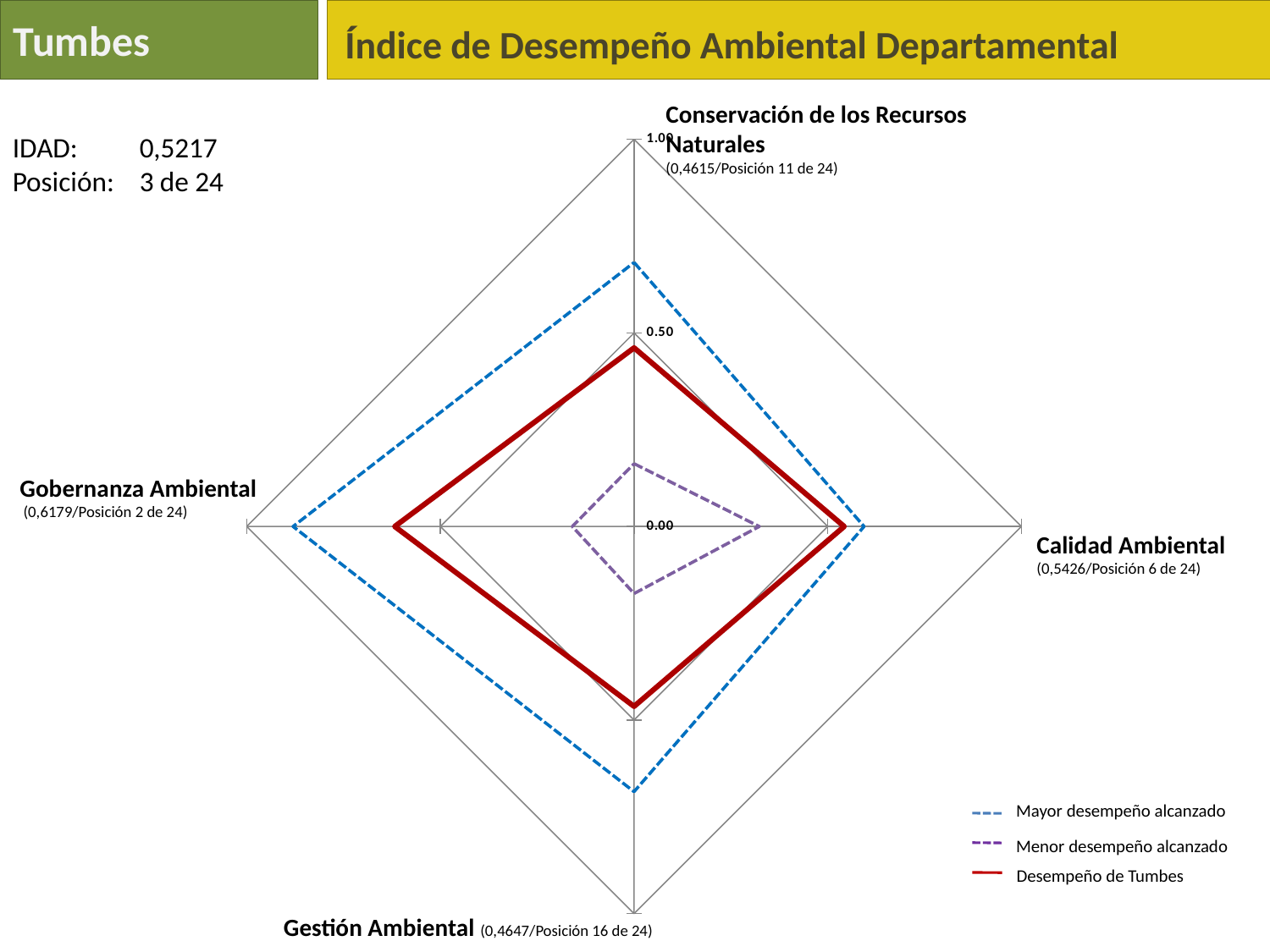
Which is larger for Tumbes: Calidad Ambiental or Gestión Ambiental? Calidad Ambiental What is the value for Calidad Ambiental in the Desempeño de Tumbes series? 0,5426 Which axis has the lowest value for Desempeño de Tumbes? Conservación de los Recursos Naturales How many series does the legend list? 3 Which axis has the highest value for Desempeño de Tumbes? Gobernanza Ambiental What is the value for Gestión Ambiental in the Desempeño de Tumbes series? 0,4647 What is the value for Conservación de los Recursos Naturales in the Desempeño de Tumbes series? 0,4615 What is the difference between the Tumbes values for Gobernanza Ambiental and Conservación de los Recursos Naturales? 0,1564 Is the value for Calidad Ambiental in the Menor desempeño alcanzado series greater or less than 0.50? less Is the value for Gobernanza Ambiental in the Mayor desempeño alcanzado series greater or less than 0.50? greater What kind of chart is shown on the slide? Radar chart What is the value for Gobernanza Ambiental in the Desempeño de Tumbes series? 0,6179